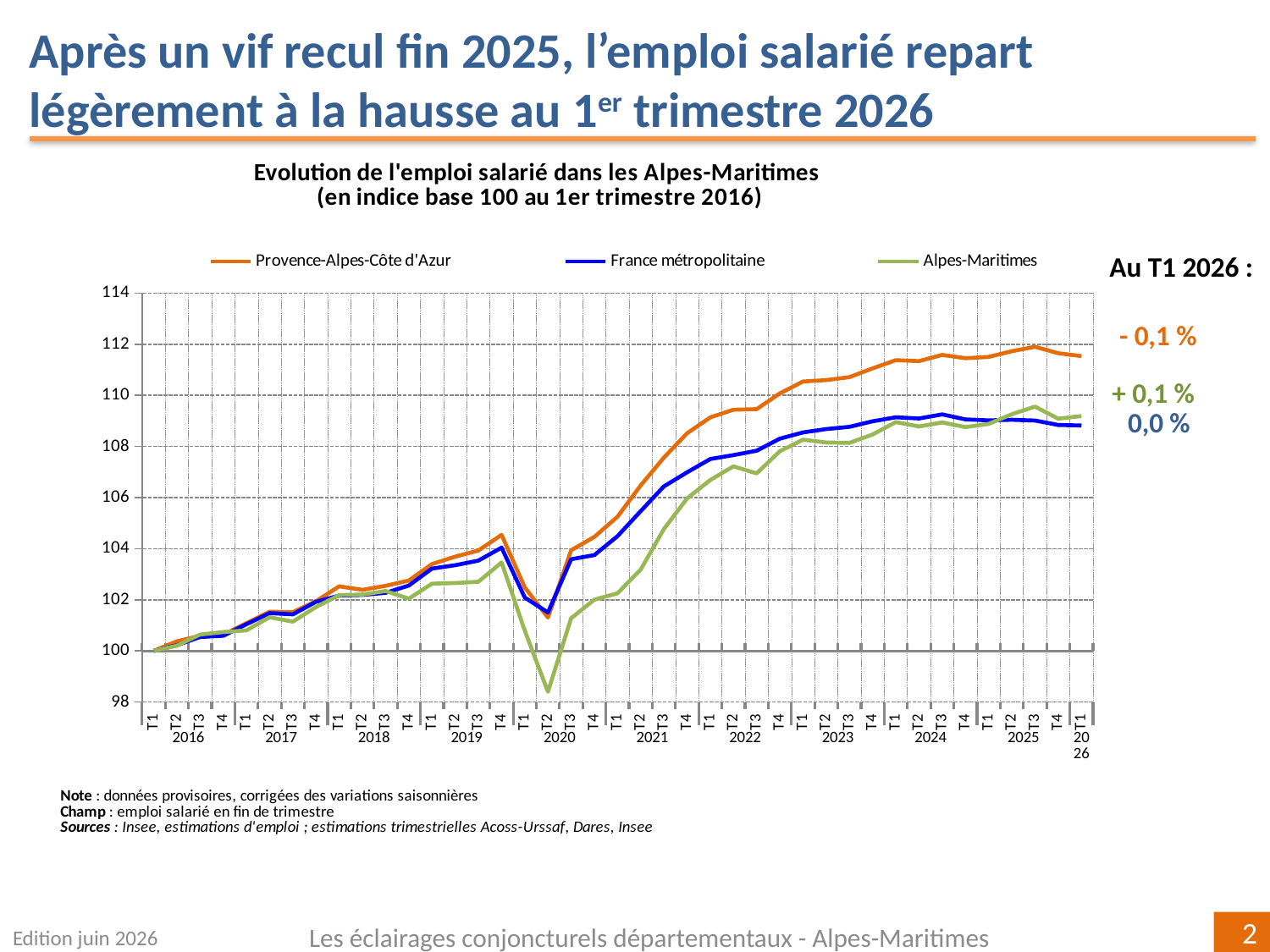
At T1 2026, which series has the higher value, Provence-Alpes-Côte d'Azur or France métropolitaine? Provence-Alpes-Côte d'Azur What is the title of the chart? Evolution de l'emploi salarié dans les Alpes-Maritimes (en indice base 100 au 1er trimestre 2016) Overall, from T1 2016 to T1 2026, does the Provence-Alpes-Côte d'Azur series rise or fall? rise Is the value for Provence-Alpes-Côte d'Azur at T1 2026 greater or less than 110? greater At T2 2020, which series has the lower value, Alpes-Maritimes or France métropolitaine? Alpes-Maritimes According to the annotation on the right, what is the change for Alpes-Maritimes at T1 2026? + 0,1 % Which series is drawn in orange? Provence-Alpes-Côte d'Azur Is the value for Alpes-Maritimes at T2 2020 greater or less than 100? less How many series does the legend list? 3 Is the value for Alpes-Maritimes at T1 2026 greater or less than 108? greater In which quarter does the Alpes-Maritimes series reach its lowest value? T2 2020 What type of chart is shown on the slide? line chart